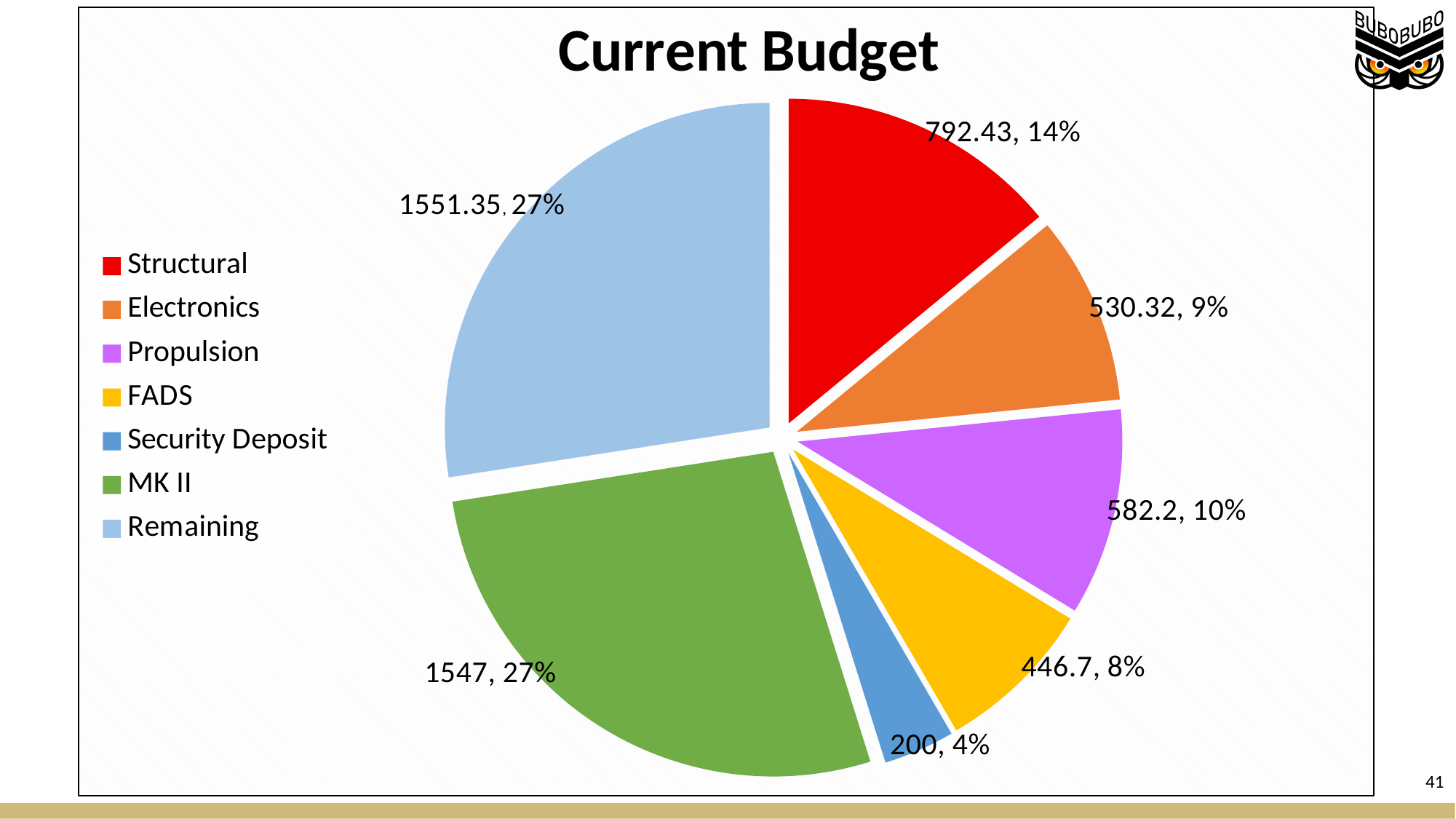
What is the value shown for the Electronics slice? 530.32 What is the value shown for the MK II slice? 1547 Which category has the smallest slice of the pie? Security Deposit What is the difference between the Structural value and the Electronics value? 262.11 What is the difference between the Propulsion value and the FADS value? 135.5 What percentage share of the pie does the Propulsion slice represent? 10% Which is larger, the Structural slice or the Propulsion slice? Structural What is the value shown for the Security Deposit slice? 200 What type of chart is shown on the slide? Pie chart What is the value shown for the Structural slice? 792.43 What percentage share of the pie does the FADS slice represent? 8% How many categories does the pie chart show? 7